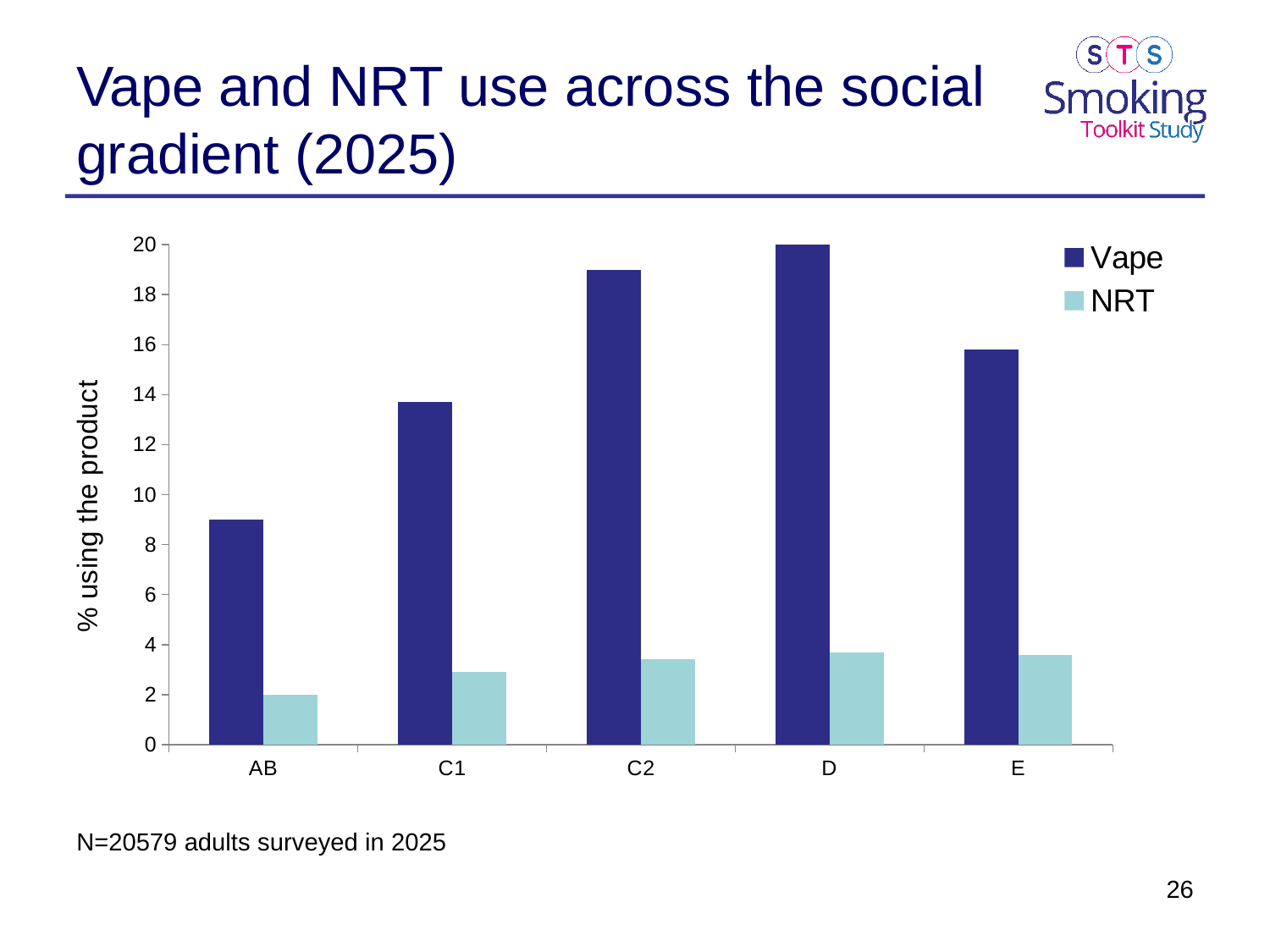
Which social grade has the lowest Vape value? AB Is the NRT value for C2 greater or less than 4? less Which social grade has the highest Vape value? D Which social grade has the lowest NRT value? AB How many social grade categories are shown on the x axis? 5 How many series does the legend list? 2 Is the Vape value for E greater or less than 16? less What is the label on the y axis? % using the product Which is larger, the Vape value for C2 or the Vape value for E? C2 Is the Vape value for C1 greater or less than 12? greater What kind of chart is shown on the slide? bar chart Do the Vape values rise or fall from AB to D along the x axis? rise